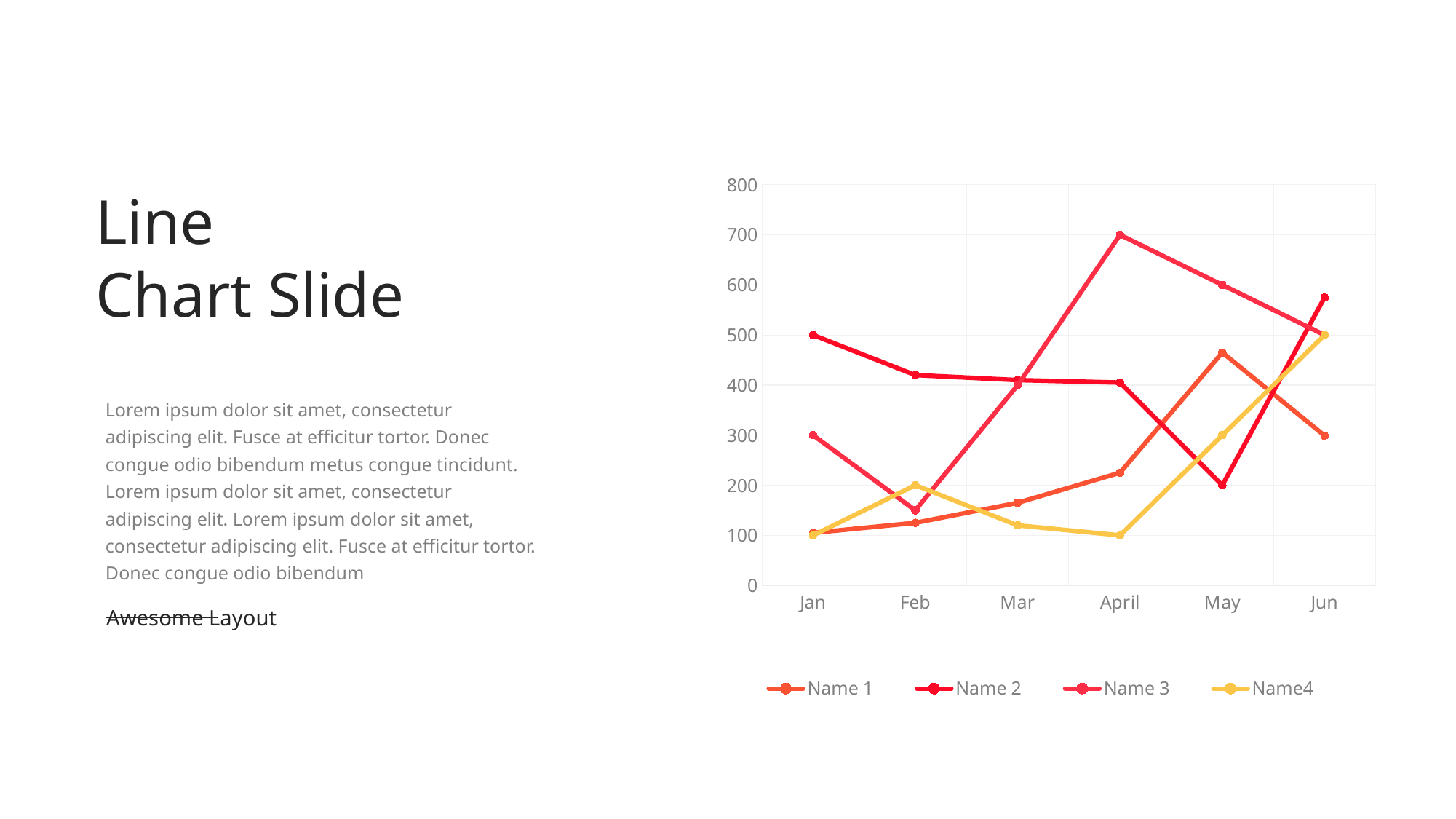
Which is larger in Jun, Name 2 or Name 1? Name 2 In which month does Name 2 have its lowest value? May What is the value for Name 2 in Jan? 500 Which series has the highest value in April? Name 3 What is the value for Name 3 in April? 700 Does Name 3 rise or fall from April to Jun? fall In which month does Name 3 reach its highest value? April What kind of chart is shown on the slide? line chart What is the value for Name4 in Jun? 500 Is the value for Name 1 in May greater or less than 400? greater How many months are shown on the x axis? 6 How many series does the legend list? 4